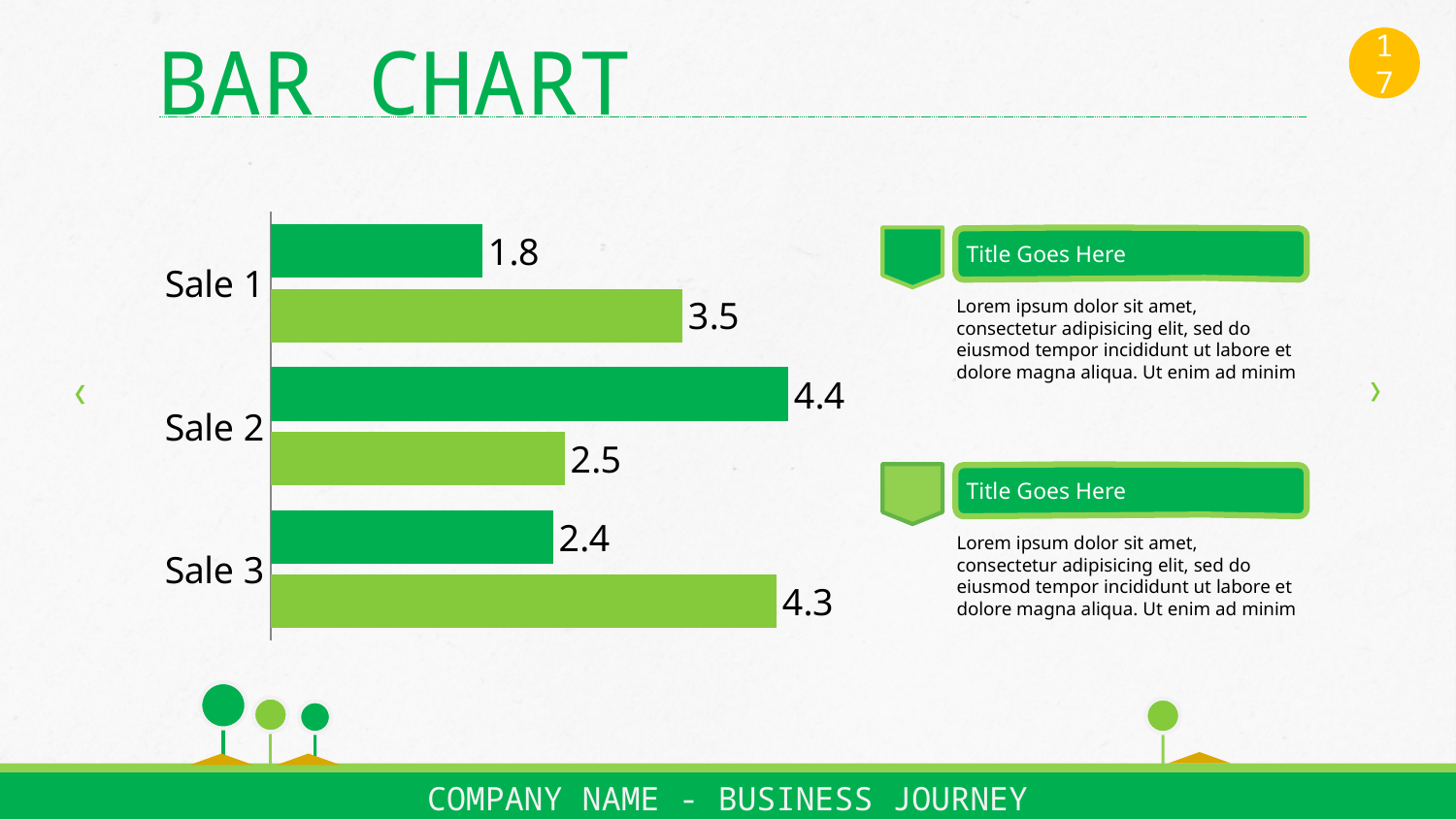
What is the value of the dark green bar for Sale 2? 4.4 For Sale 3, which bar is larger, the dark green or the light green? light green What is the value of the light green bar for Sale 3? 4.3 What is the difference between the light green and dark green bars for Sale 1? 1.7 What kind of chart is shown on the slide? bar chart What is the value of the light green bar for Sale 2? 2.5 What is the value of the dark green bar for Sale 1? 1.8 What is the title of the slide containing the chart? BAR CHART Which category has the lowest dark green bar? Sale 1 What is the difference between the dark green and light green bars for Sale 2? 1.9 How many categories are shown on the chart? 3 Which category has the highest dark green bar? Sale 2